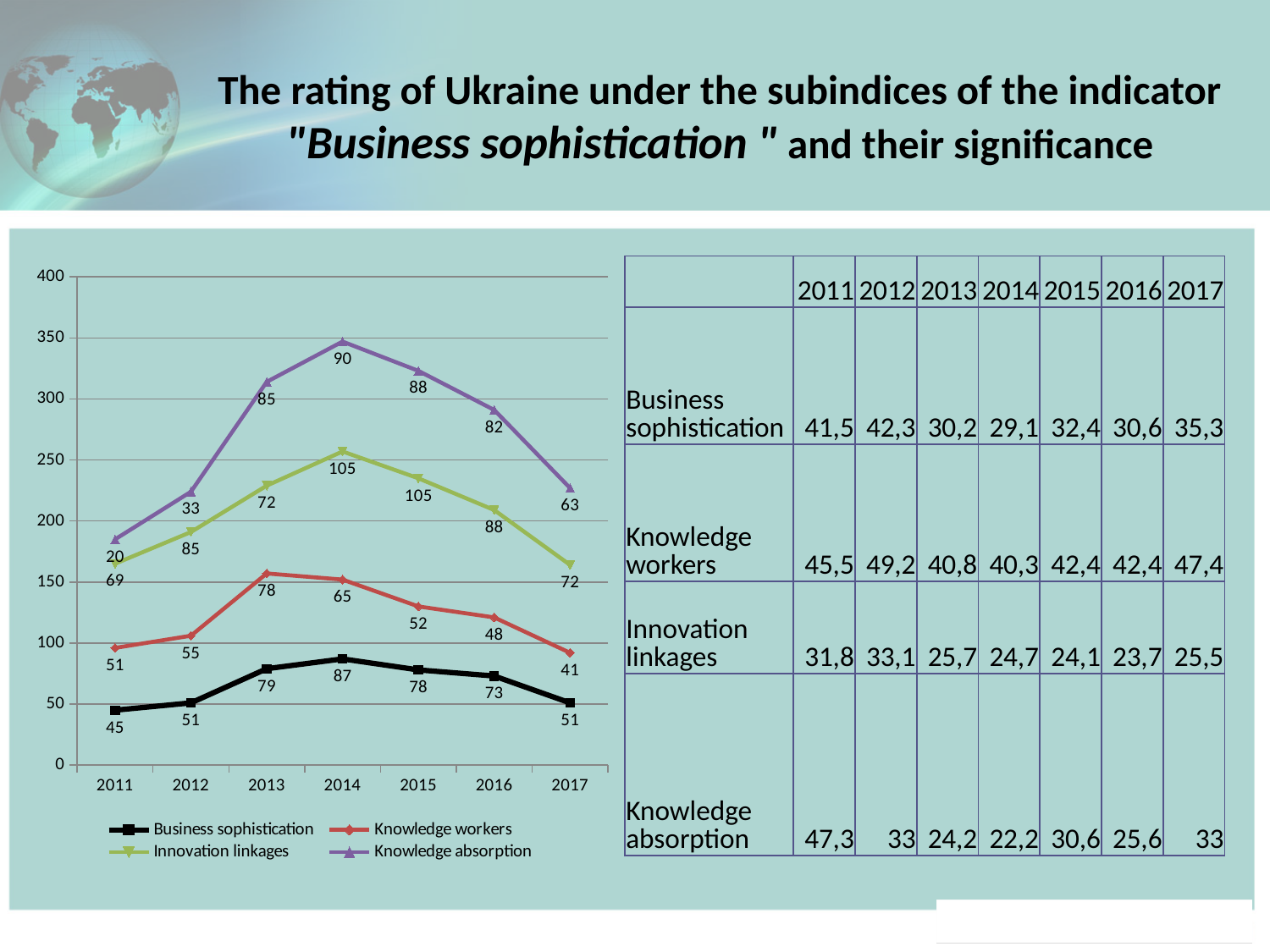
What is the data label for Knowledge workers in 2017? 41 In which year does the Business sophistication series have its highest data label? 2014 Which series is drawn in black on the chart? Business sophistication How many years are shown on the x axis of the chart? 7 In which year does the Knowledge absorption series have its lowest data label? 2011 What is the data label for Business sophistication in 2014? 87 How many series does the chart legend list? 4 What type of chart is shown on the slide? line chart What is the data label for Knowledge absorption in 2011? 20 What is the difference between the Knowledge workers data labels for 2013 and 2017? 37 What is the data label for Innovation linkages in 2012? 85 Which is larger: the Innovation linkages data label in 2014 or the Knowledge absorption data label in 2014? Innovation linkages